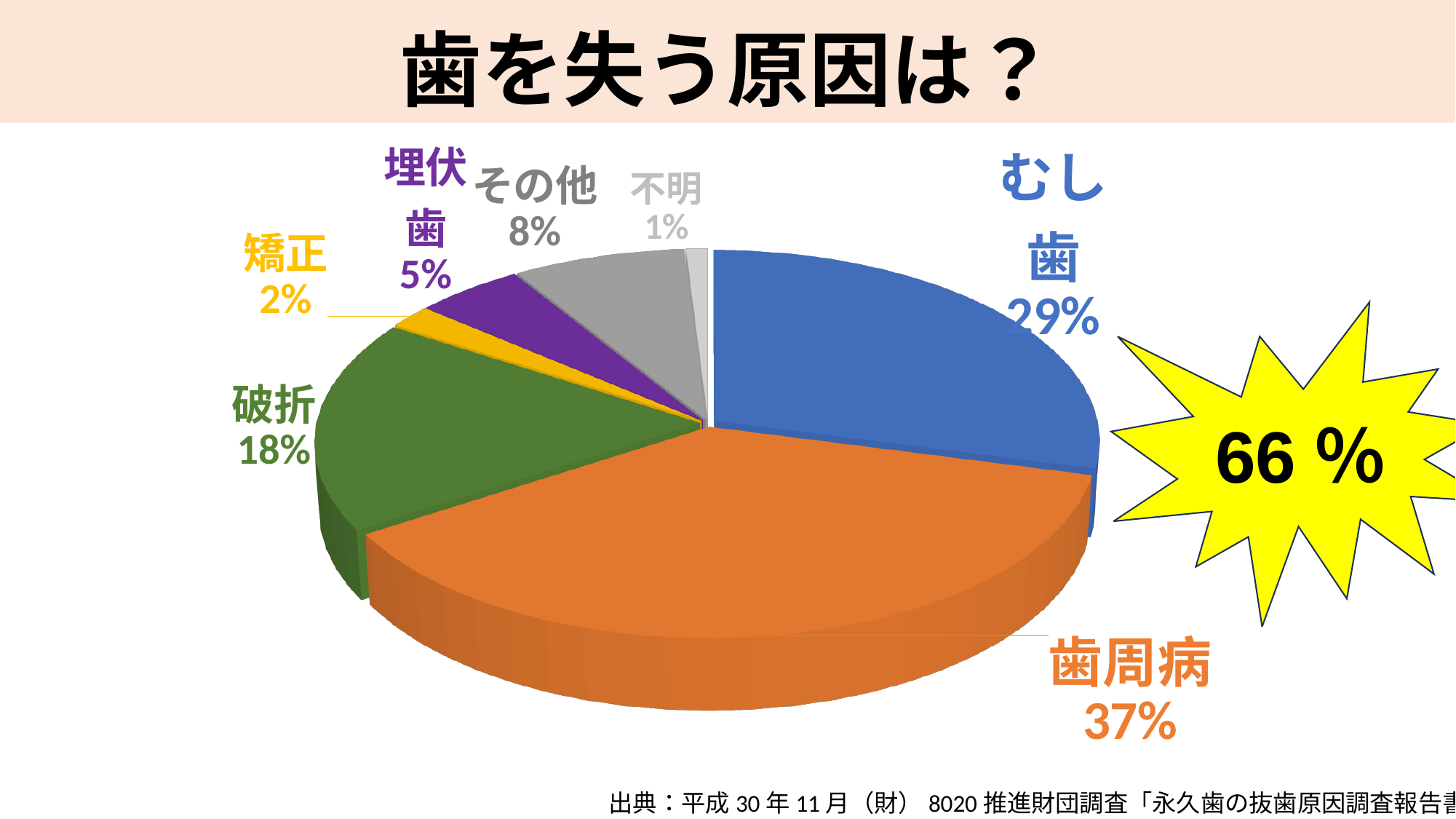
What percentage of the pie is 歯周病? 37% What percentage of the pie is むし歯? 29% What is the title of the slide? 歯を失う原因は？ What is the difference in percentage points between 歯周病 and むし歯? 8 How many categories are shown in the pie chart? 7 What percentage of the pie is その他? 8% Which category has the smallest share of the pie? 不明 What kind of chart is shown on the slide? pie chart Which is larger, the share for 破折 or the share for その他? 破折 What percentage of the pie is 破折? 18% Which category has the largest share of the pie? 歯周病 What percentage of the pie is 埋伏歯? 5%